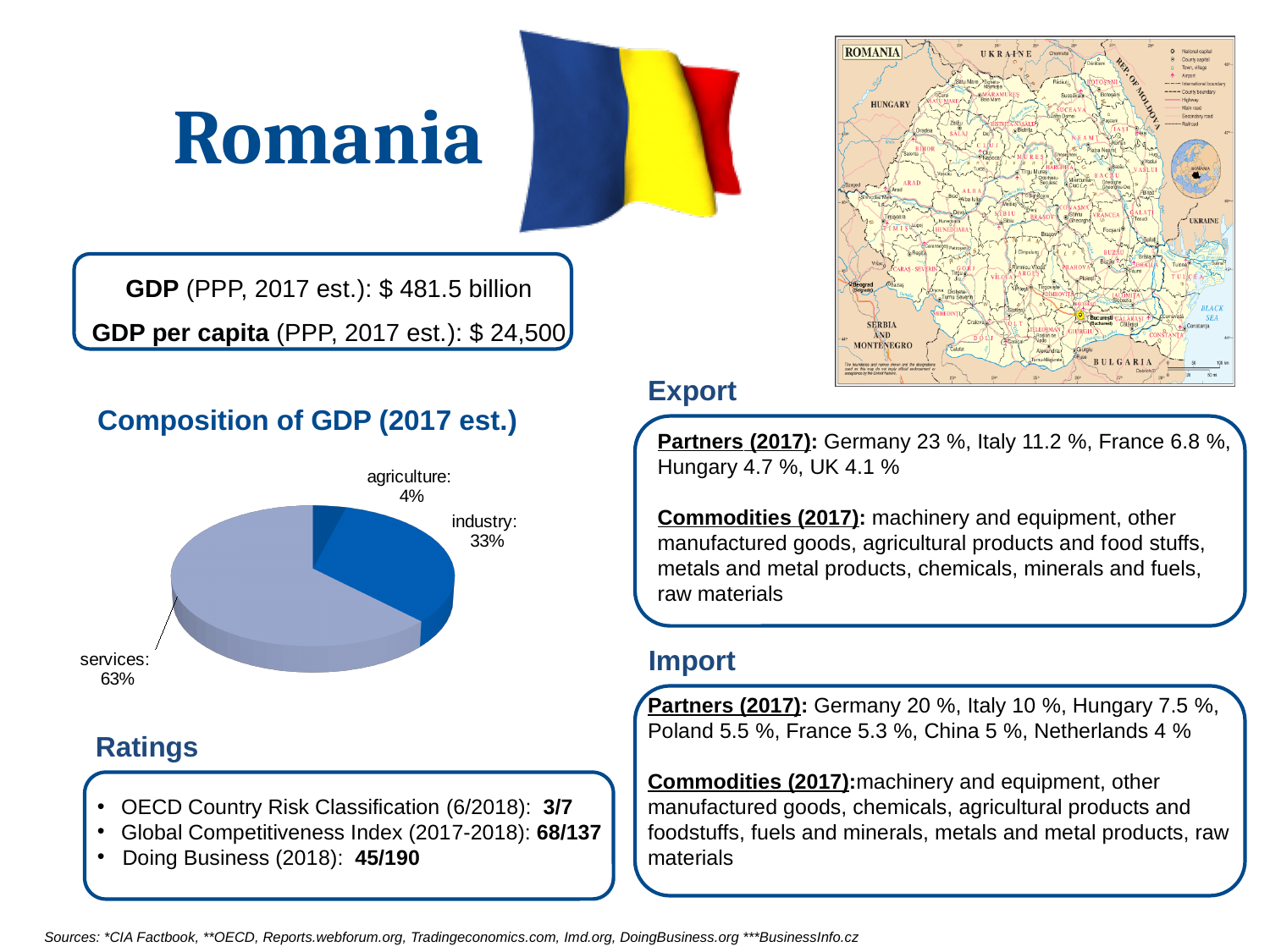
Which is larger in the Composition of GDP chart, the industry share or the agriculture share? industry What is the title of the chart on the slide? Composition of GDP (2017 est.) What share of GDP does agriculture account for in the Composition of GDP (2017 est.) chart? 4% How many sectors are shown in the Composition of GDP (2017 est.) chart? 3 What type of chart is used to show the Composition of GDP (2017 est.)? pie chart What is the combined share of industry and agriculture in the Composition of GDP chart? 37% What is the difference in percentage points between the industry and agriculture shares in the Composition of GDP chart? 29 Which sector has the largest share in the Composition of GDP (2017 est.) chart? services Which sector has the smallest share in the Composition of GDP (2017 est.) chart? agriculture What share of GDP does industry account for in the Composition of GDP (2017 est.) chart? 33% What share of GDP does services account for in the Composition of GDP (2017 est.) chart? 63% What is the difference in percentage points between the services and industry shares in the Composition of GDP chart? 30